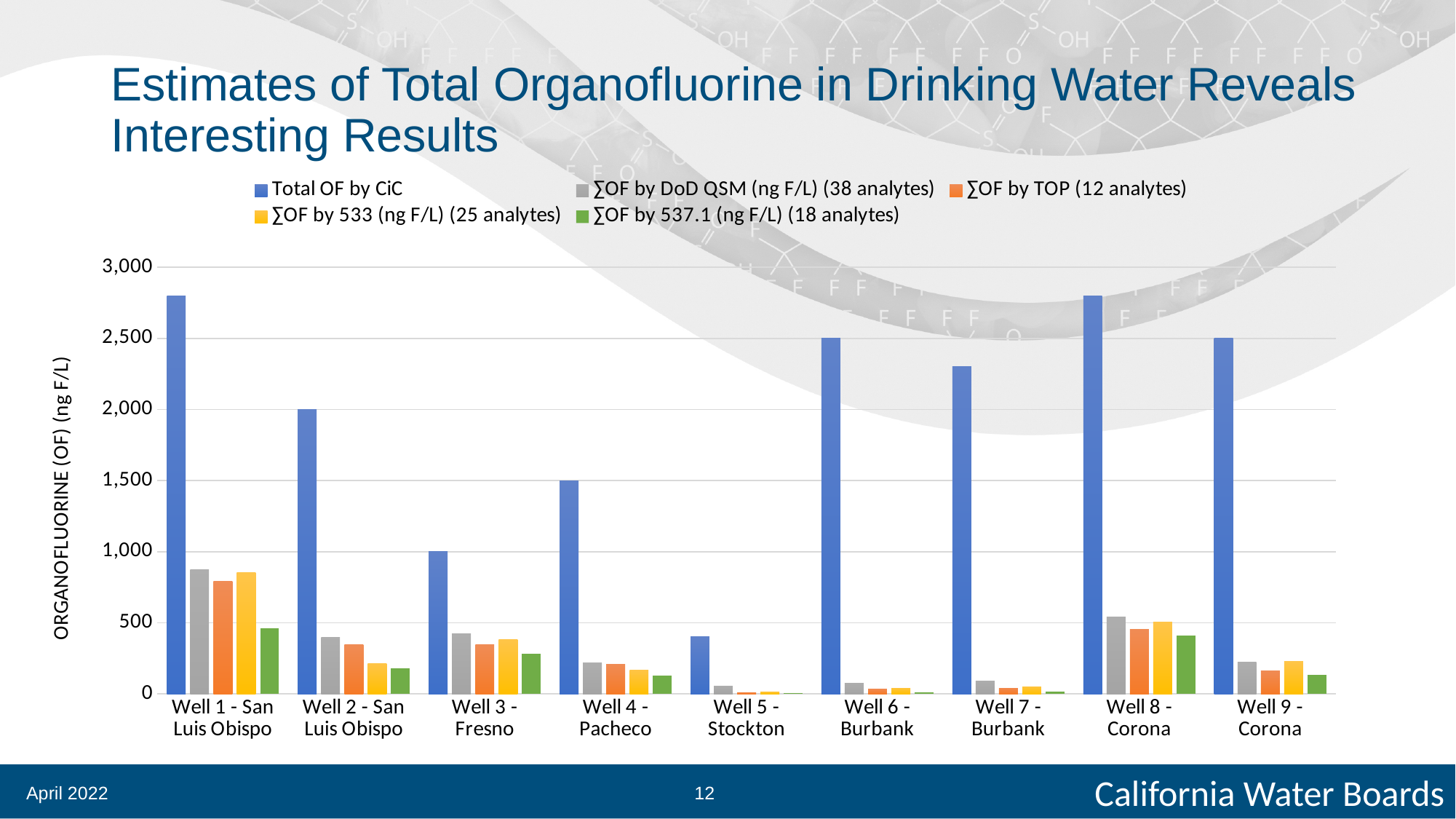
What is the Total OF by CiC value for Well 2 - San Luis Obispo? 2,000 How many series does the legend list? 5 What is the Total OF by CiC value for Well 3 - Fresno? 1,000 Which has the larger Total OF by CiC value, Well 6 - Burbank or Well 7 - Burbank? Well 6 - Burbank What is the difference between the Total OF by CiC values for Well 2 - San Luis Obispo and Well 3 - Fresno? 1,000 What is the Total OF by CiC value for Well 4 - Pacheco? 1,500 How many wells (categories) are shown on the x axis? 9 What is the label on the y axis? ORGANOFLUORINE (OF) (ng F/L) Is the Total OF by CiC value for Well 7 - Burbank greater or less than 2,000? greater Is the Total OF by CiC value for Well 5 - Stockton greater or less than 500? less Which well has the lowest Total OF by CiC value? Well 5 - Stockton What kind of chart is shown on the slide? bar chart